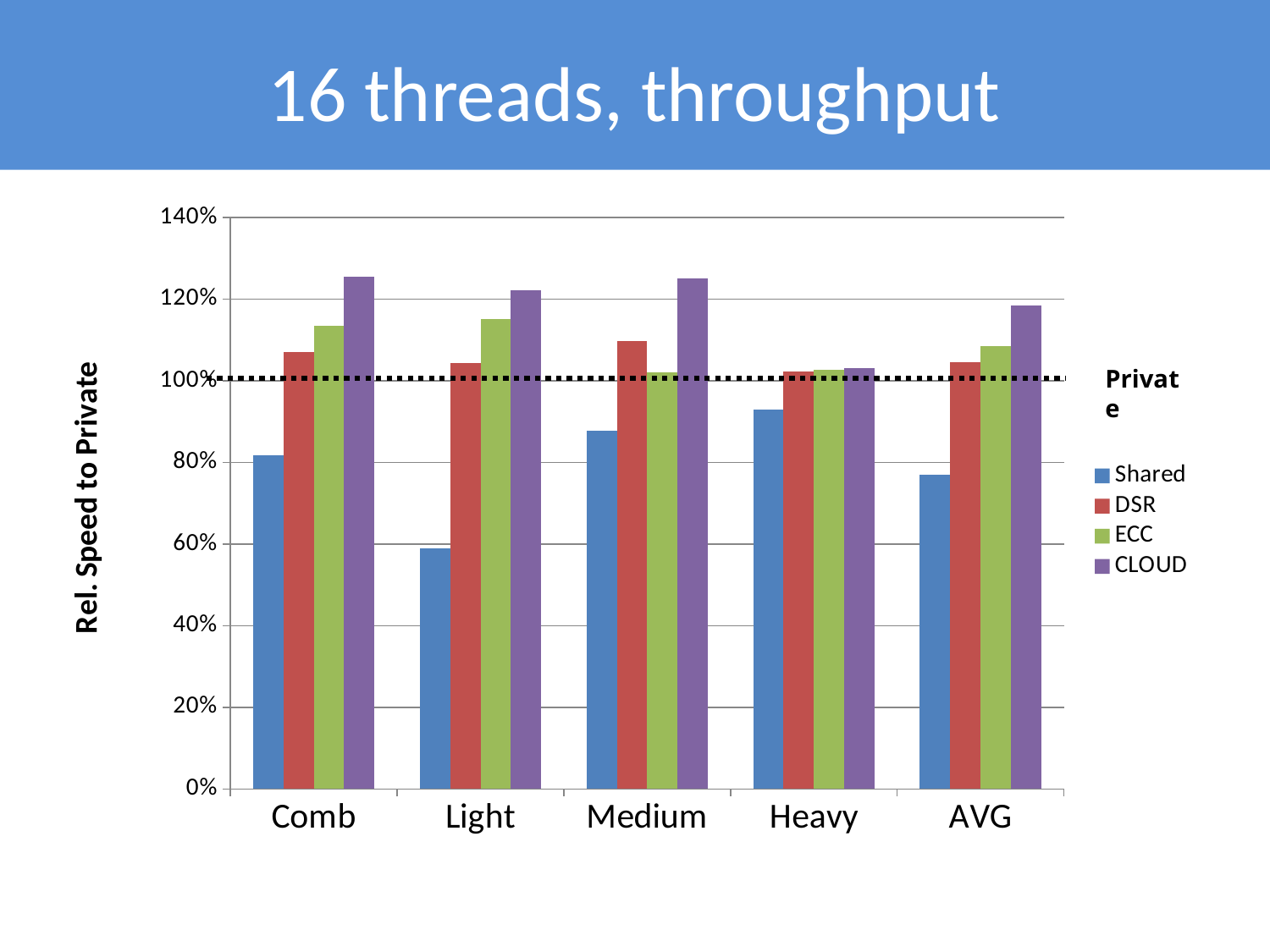
Is the CLOUD value for Comb greater or less than 120%? greater For Comb, which is larger: the Shared value or the CLOUD value? CLOUD How many series does the legend list? 4 How many categories are shown on the x axis? 5 Is the Shared value for Heavy greater or less than 100%? less What kind of chart is shown on the slide? bar chart In which category is the Shared series lowest? Light Is the ECC value for AVG greater or less than 100%? greater What is the title of the y axis? Rel. Speed to Private For Light, which series has the highest value? CLOUD For Light, which is larger: the DSR value or the ECC value? ECC